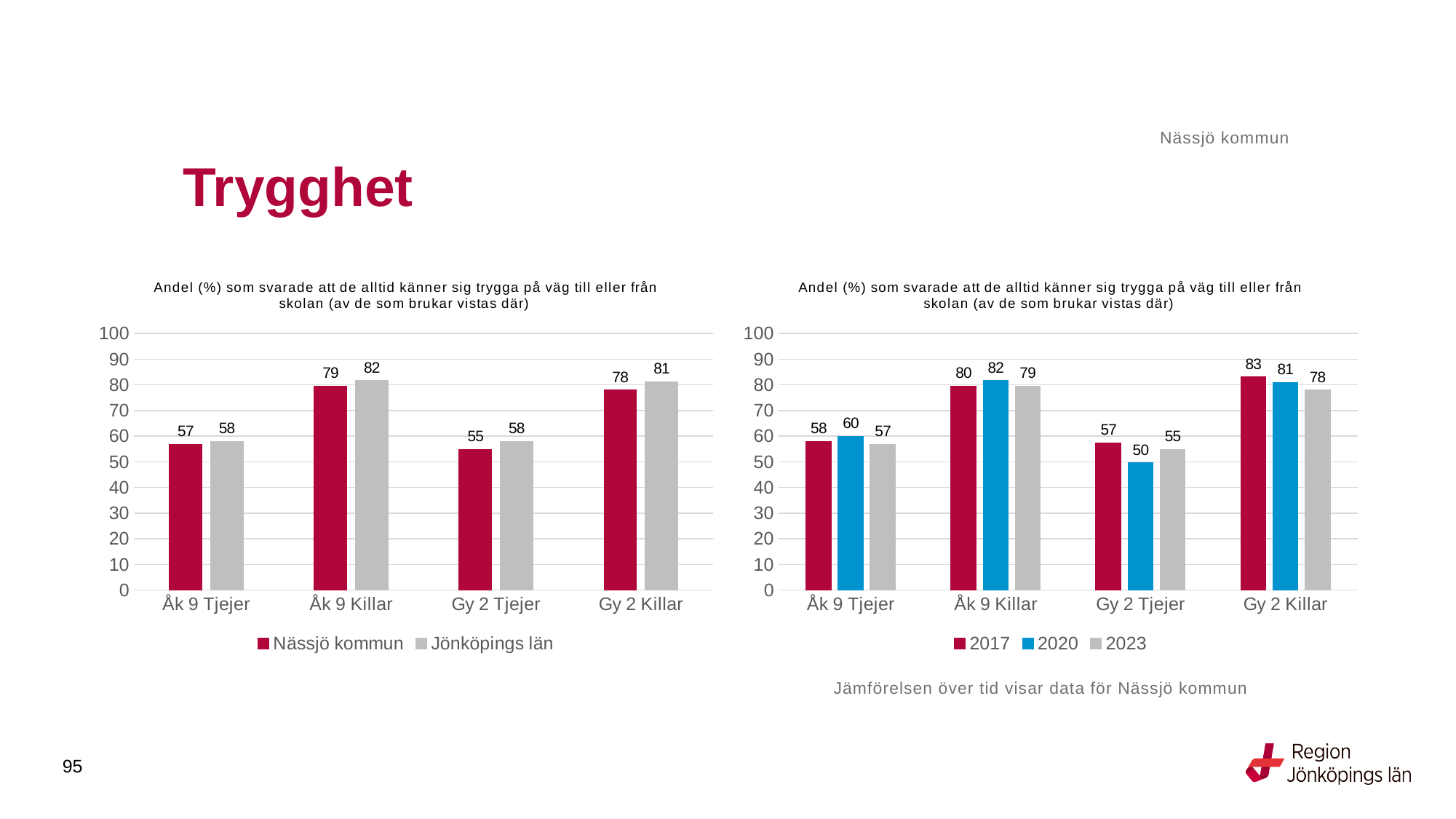
In the left chart, how many series does the legend list? 2 What kind of chart is the right chart? Bar chart In the left chart, what is the difference between Jönköpings län and Nässjö kommun for Gy 2 Killar? 3 In the right chart, what is the value for 2020 for Gy 2 Tjejer? 50 In the right chart, which year has the highest value for Gy 2 Killar? 2017 In the left chart, what is the value for Nässjö kommun for Åk 9 Killar? 79 In the right chart, what is the difference between the 2017 and 2020 values for Gy 2 Tjejer? 7 In the left chart, which category has the highest value for Jönköpings län? Åk 9 Killar In the left chart, which category has the lowest value for Nässjö kommun? Gy 2 Tjejer In the left chart, what is the value for Jönköpings län for Gy 2 Tjejer? 58 In the right chart, what is the value for 2023 for Gy 2 Killar? 78 In the right chart, is the value for 2017 or 2023 larger for Åk 9 Tjejer? 2017